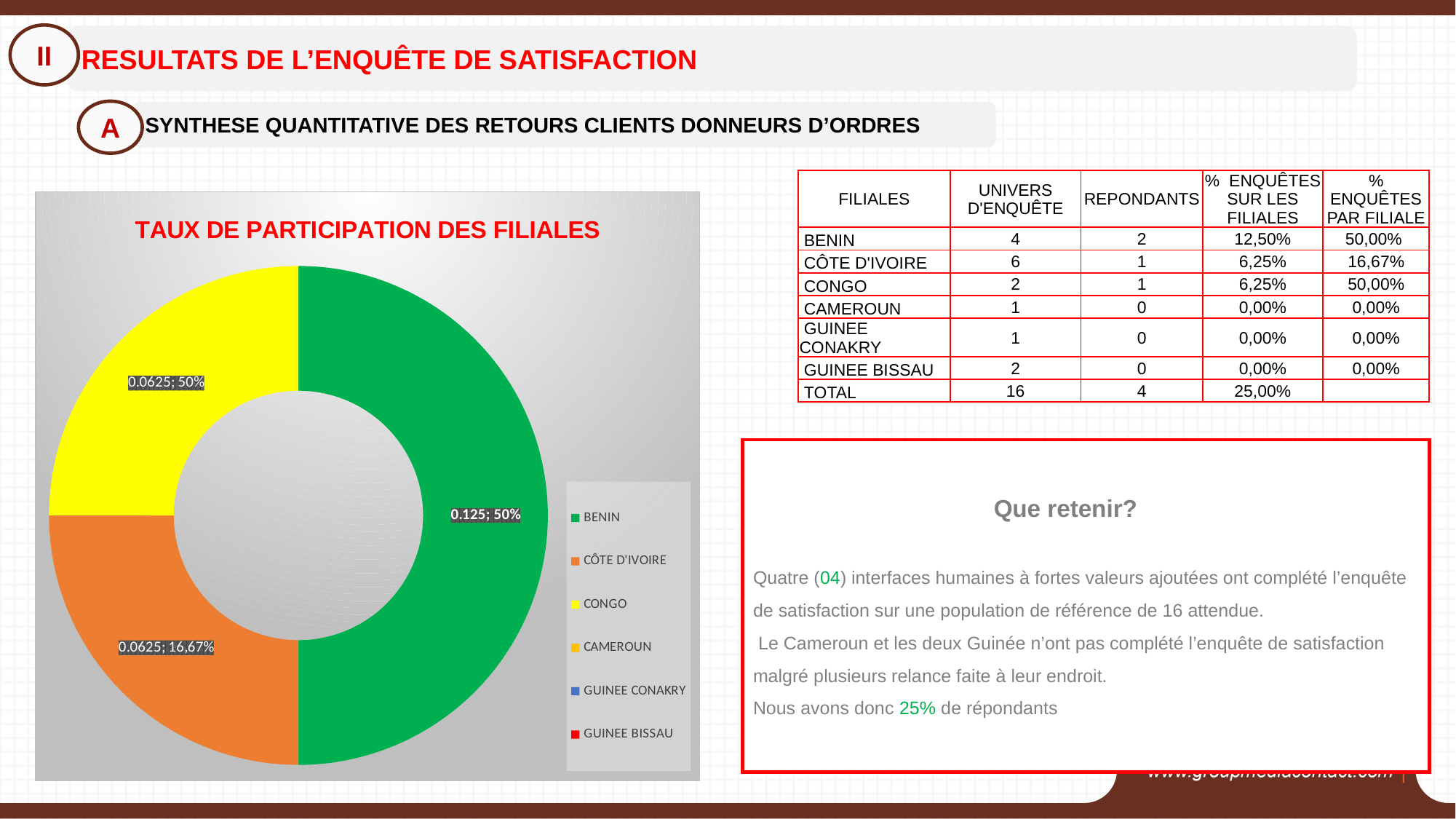
What colour is the BENIN slice in the chart? Green How many entries does the chart legend list? 6 What data label is shown on the CÔTE D'IVOIRE slice of the chart? 0.0625; 16,67% Which category has the largest slice in the chart? BENIN What kind of chart is shown on the slide? Doughnut (pie) chart What is the title of the chart? TAUX DE PARTICIPATION DES FILIALES Which slice is larger in the chart, BENIN or CÔTE D'IVOIRE? BENIN What data label is shown on the CONGO slice of the chart? 0.0625; 50% How many slices with data labels are visible in the chart? 3 What is the first value shown in the data label of the BENIN slice? 0.125 What data label is shown on the BENIN slice of the chart? 0.125; 50%